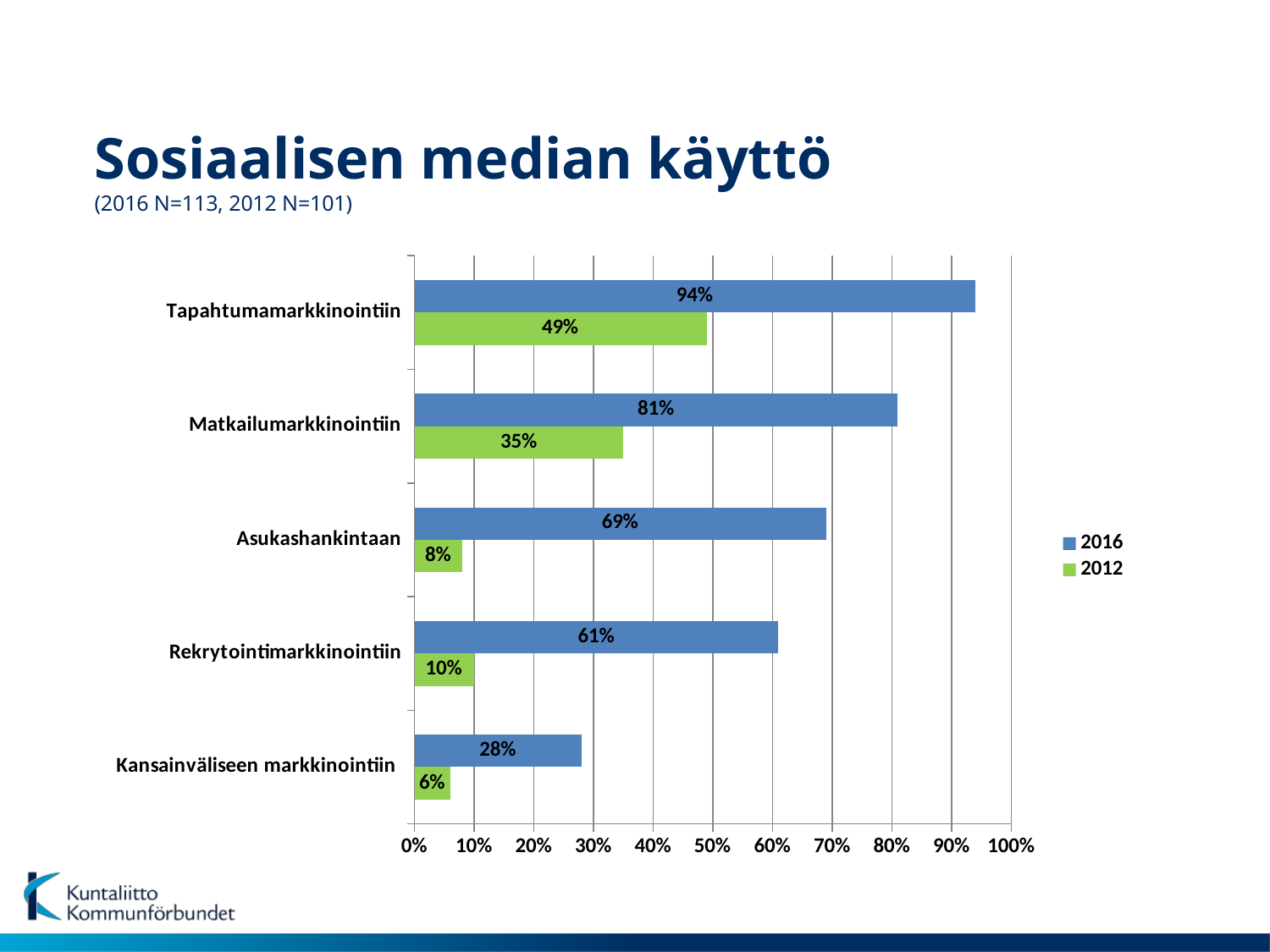
Which category has the lowest 2012 value? Kansainväliseen markkinointiin What is the 2012 value for Asukashankintaan? 8% What is the title of the chart on the slide? Sosiaalisen median käyttö How many series does the legend list? 2 What is the difference between the 2016 and 2012 values for Rekrytointimarkkinointiin? 51% Which is larger: the 2016 value for Kansainväliseen markkinointiin or the 2012 value for Tapahtumamarkkinointiin? 2012 value for Tapahtumamarkkinointiin Which category has the highest 2016 value? Tapahtumamarkkinointiin What kind of chart is shown on the slide? Bar chart What is the 2016 value for Tapahtumamarkkinointiin? 94% How many categories are shown on the chart? 5 Which colour represents the 2012 series? Green What is the 2012 value for Matkailumarkkinointiin? 35%